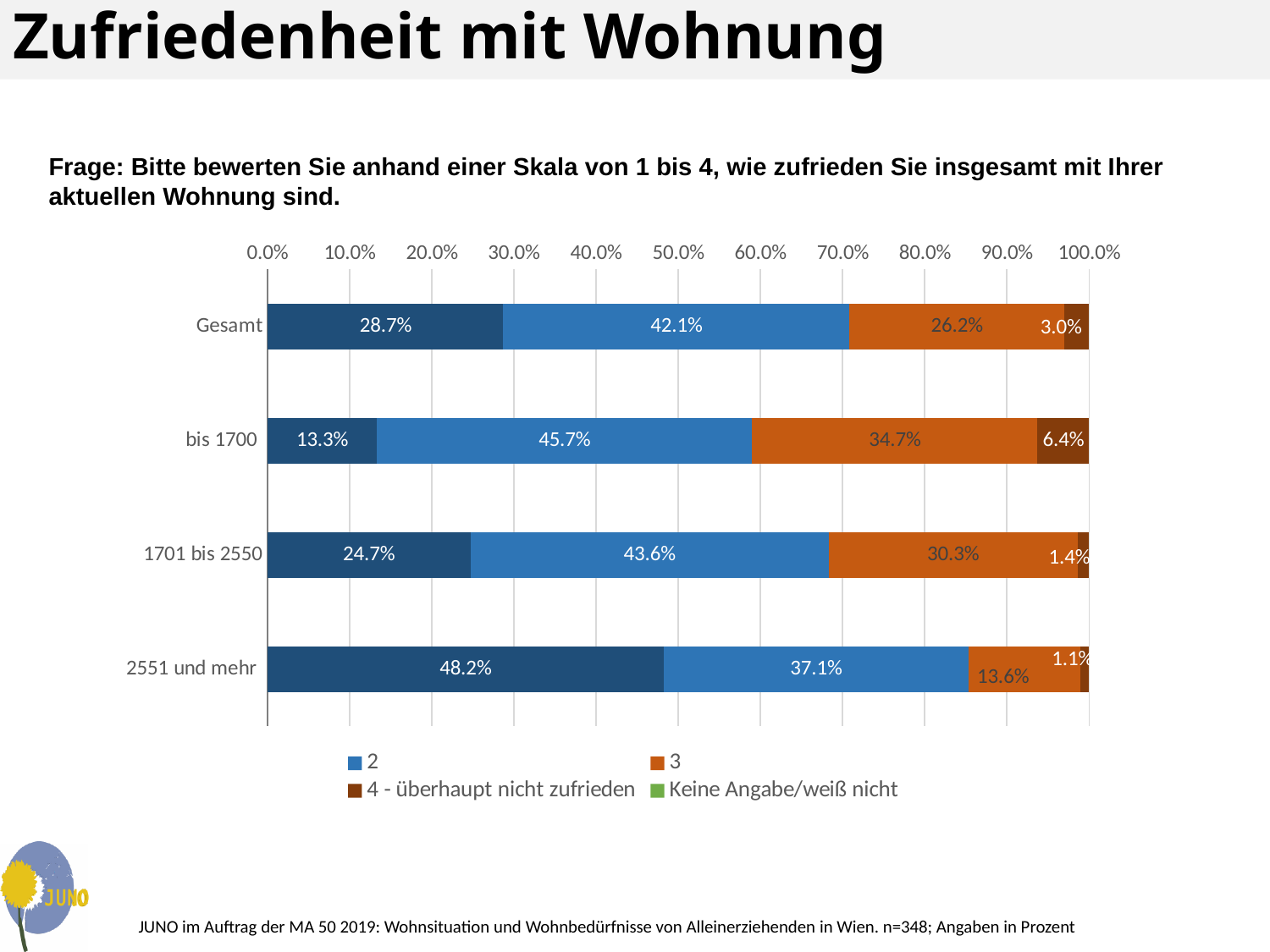
Which category has the lowest value for "4 - überhaupt nicht zufrieden"? 2551 und mehr Which has the larger value for series "3": "1701 bis 2550" or "Gesamt"? 1701 bis 2550 How many series does the legend list? 4 What kind of chart is shown on the slide? Stacked bar chart How many categories are shown on the chart? 4 What is the difference between the series "2" values for "Gesamt" and "2551 und mehr"? 5.0 percentage points Is the value of series "2" for "bis 1700" greater or less than 40%? greater What is the value of series "3" for the category "bis 1700"? 34.7% What is the value of "4 - überhaupt nicht zufrieden" for the category "2551 und mehr"? 1.1% Which category has the highest value for series "3"? bis 1700 What is the difference between the "4 - überhaupt nicht zufrieden" values for "bis 1700" and "Gesamt"? 3.4 percentage points What is the value of series "2" for the category "Gesamt"? 42.1%